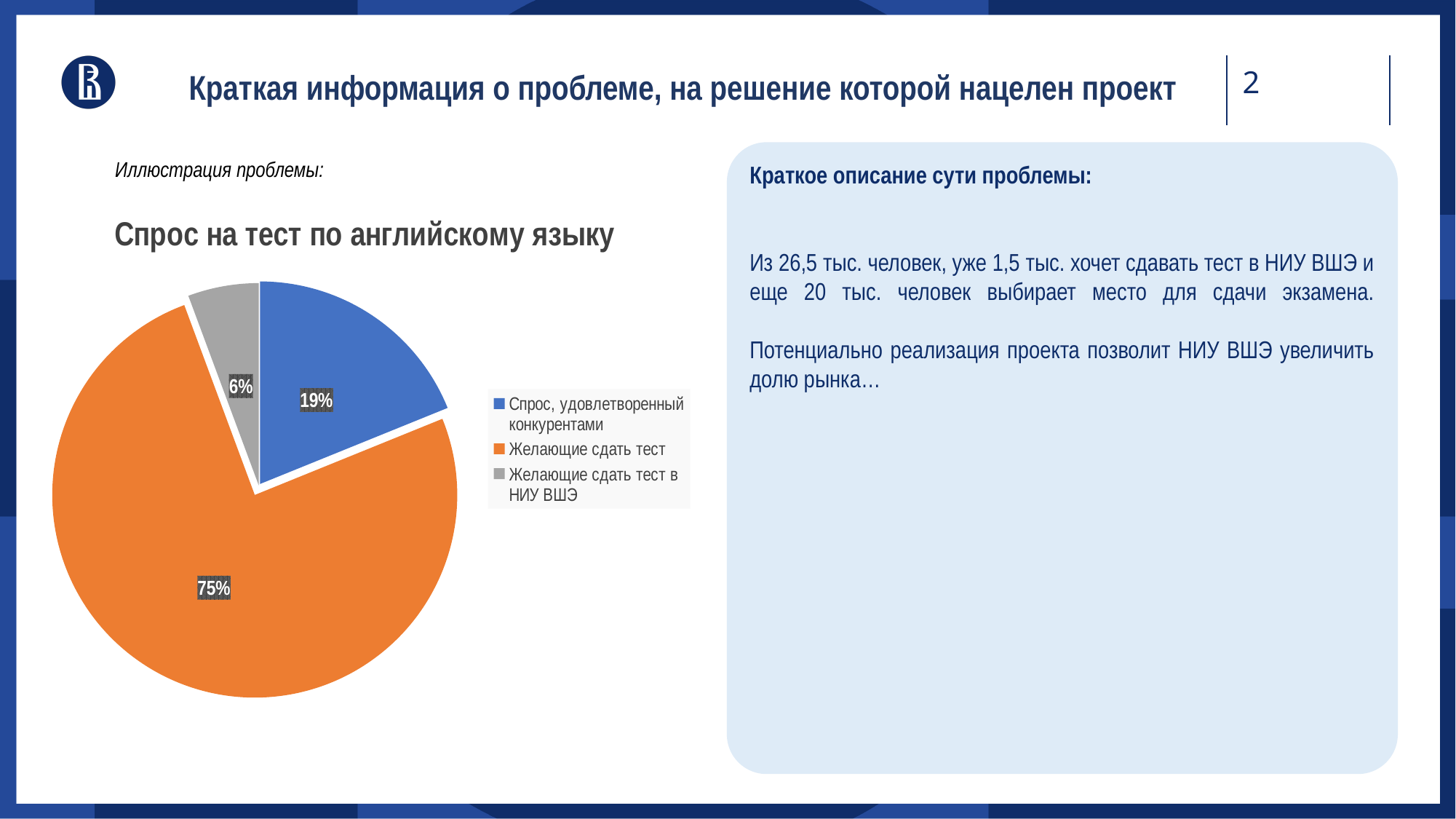
What share of the pie is labelled 'Спрос, удовлетворенный конкурентами'? 19% What is the title of the chart? Спрос на тест по английскому языку What share of the pie is labelled 'Желающие сдать тест в НИУ ВШЭ'? 6% What share of the pie is labelled 'Желающие сдать тест'? 75% How many categories does the legend list? 3 Which category has the smallest slice of the pie? Желающие сдать тест в НИУ ВШЭ What is the difference in percentage points between 'Спрос, удовлетворенный конкурентами' and 'Желающие сдать тест в НИУ ВШЭ'? 13 What is the difference in percentage points between 'Желающие сдать тест' and 'Спрос, удовлетворенный конкурентами'? 56 Which is larger: the slice for 'Спрос, удовлетворенный конкурентами' or the slice for 'Желающие сдать тест в НИУ ВШЭ'? Спрос, удовлетворенный конкурентами What kind of chart is shown on the slide? pie chart Which category has the largest slice of the pie? Желающие сдать тест What colour is the slice for 'Желающие сдать тест'? orange